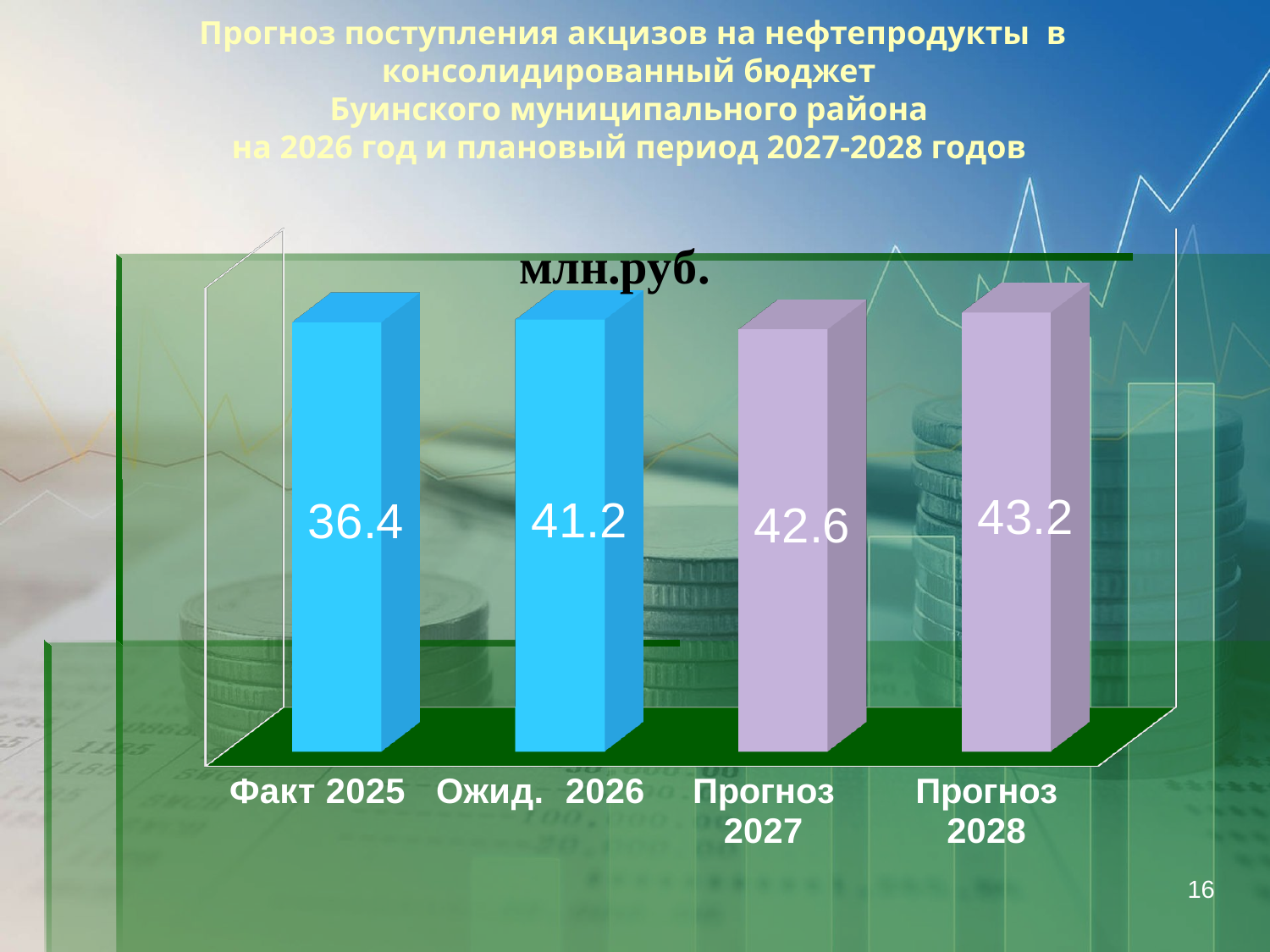
How many categories are shown in the chart? 4 What is the value for Прогноз 2028? 43.2 What kind of chart is shown on the slide? bar chart What is the value for Прогноз 2027? 42.6 What is the difference between the values for Ожид. 2026 and Факт 2025? 4.8 Which category has the highest value? Прогноз 2028 What is the difference between the values for Прогноз 2028 and Прогноз 2027? 0.6 Do the values rise or fall from Факт 2025 to Прогноз 2028? rise Which category has the lowest value? Факт 2025 What is the value for Ожид. 2026? 41.2 What is the value for Факт 2025? 36.4 Which is larger, the value for Ожид. 2026 or the value for Факт 2025? Ожид. 2026